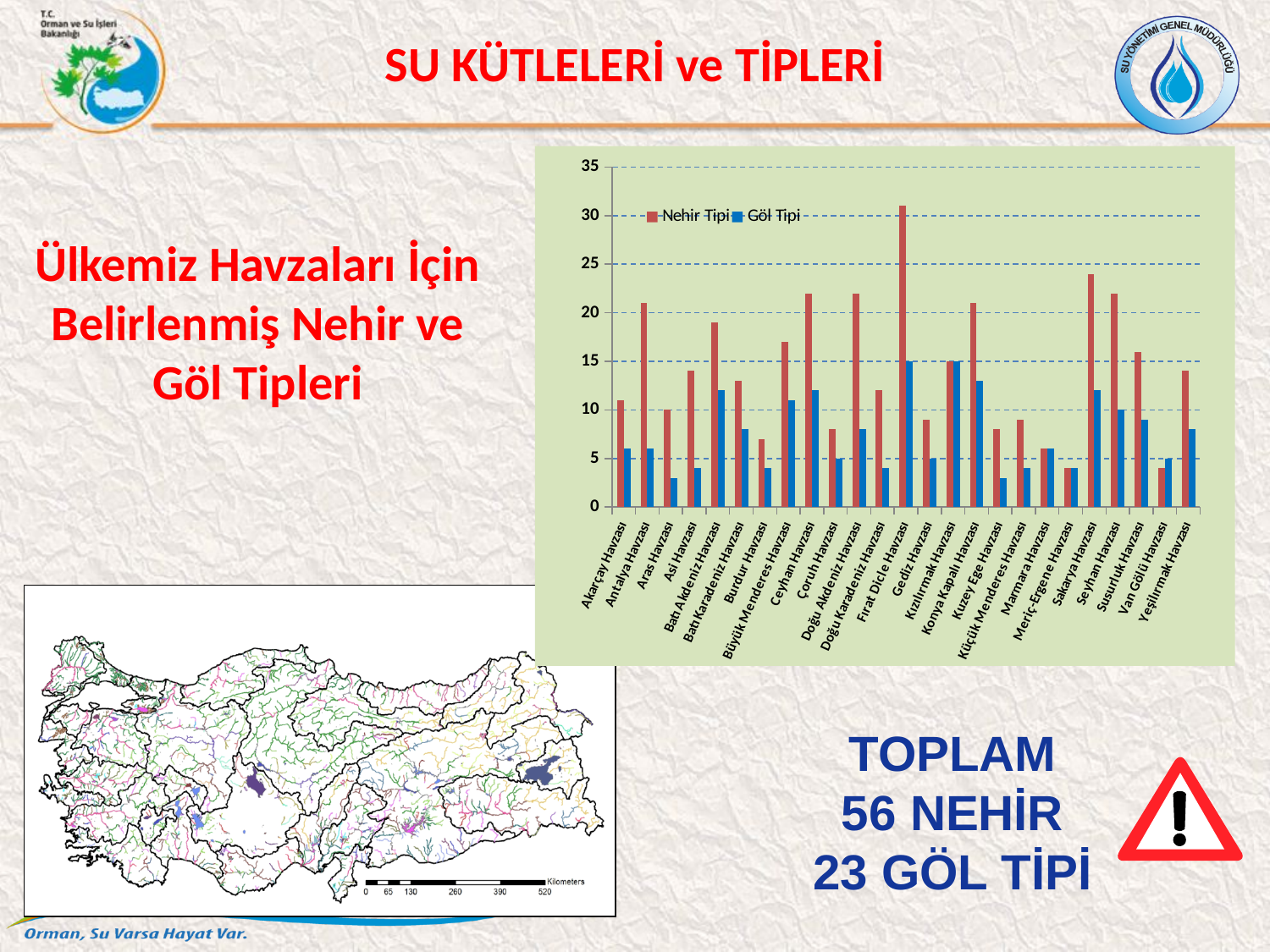
Which basin has the larger Nehir Tipi value, Fırat Dicle Havzası or Sakarya Havzası? Fırat Dicle Havzası Which basin has the highest Nehir Tipi value in the chart? Fırat Dicle Havzası Is the Nehir Tipi value for Sakarya Havzası greater or less than 20? greater What are the two series named in the chart legend? Nehir Tipi and Göl Tipi How many basins (havza) are shown along the x axis of the chart? 25 Is the Göl Tipi value for Küçük Menderes Havzası greater or less than 5? less Is the Nehir Tipi value for Fırat Dicle Havzası greater or less than 25? greater Which is larger for Akarçay Havzası, the Nehir Tipi value or the Göl Tipi value? Nehir Tipi What kind of chart is shown on the slide? bar chart How many series does the chart's legend list? 2